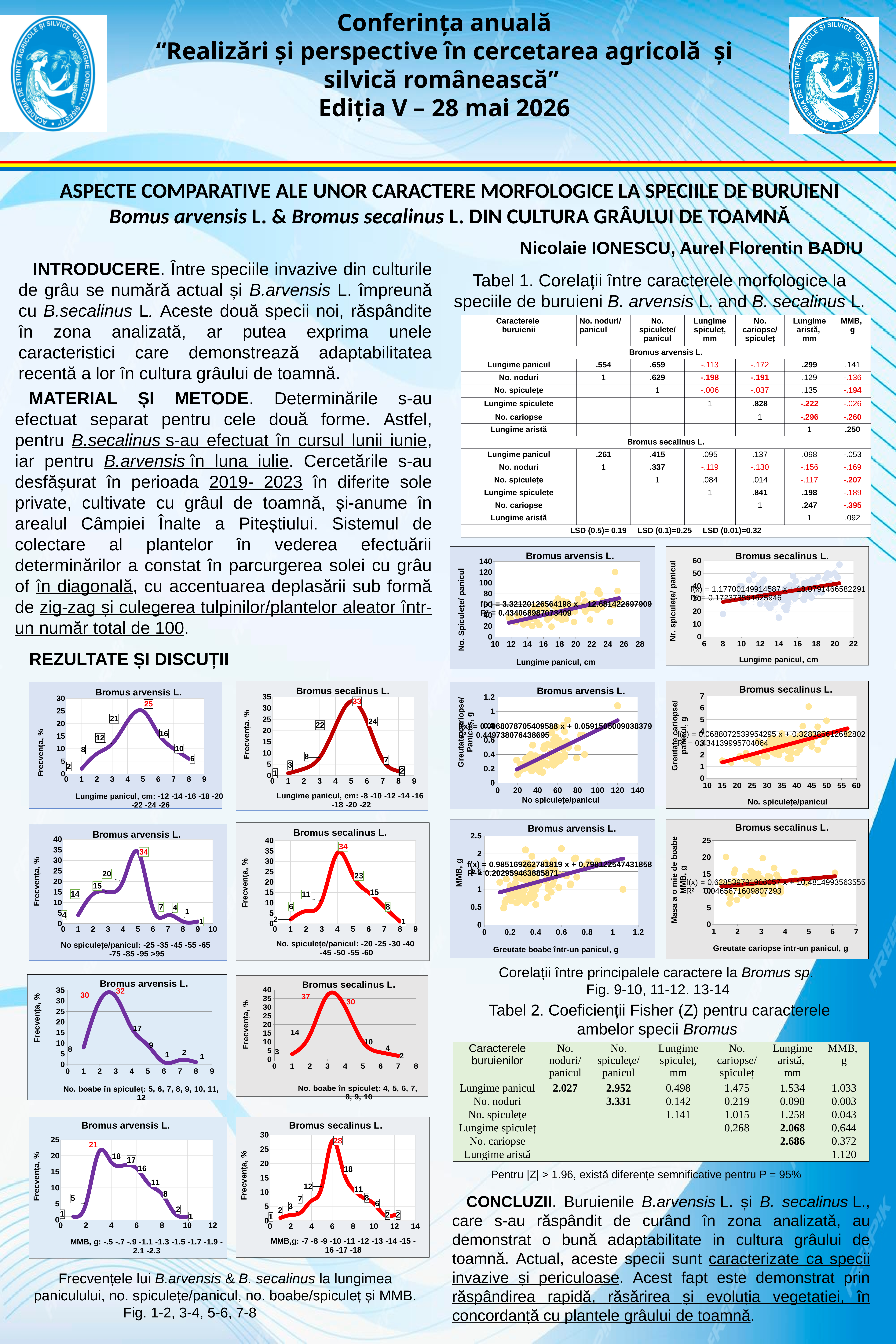
In the Bromus arvensis L. chart of Frecvența % by MMB, g, what is the highest labelled value? 21 What kind of chart is the Bromus arvensis L. chart with x-axis Lungime panicul, cm and y-axis No. Spiculețe/panicul? scatter chart In the Bromus secalinus L. chart of Frecvența % by No. spiculețe/panicul, what is the difference between the peak value 34 and the next labelled value 23? 11 In the Bromus arvensis L. chart of Frecvența % by Lungime panicul, cm, what is the difference between the labelled values 25 and 21? 4 How many data points are labelled in the Bromus secalinus L. chart of Frecvența % by MMB, g? 12 In the Bromus secalinus L. line chart of Frecvența % by Lungime panicul, cm, what is the highest frequency value labelled? 33 In the Bromus secalinus L. chart of Frecvența % by No. boabe în spiculeț, what is the difference between the two highest labelled values (37 and 30)? 7 What kind of chart is the Bromus arvensis L. chart of Frecvența % by MMB, g? line chart In the Bromus arvensis L. chart of Frecvența % by No spiculețe/panicul, what is the peak labelled value? 34 In the Bromus arvensis L. chart of Frecvența % by No. boabe în spiculeț, which labelled value is larger, 30 or 32? 32 What colour is the line in the Bromus secalinus L. frequency charts on the left side of the slide? red